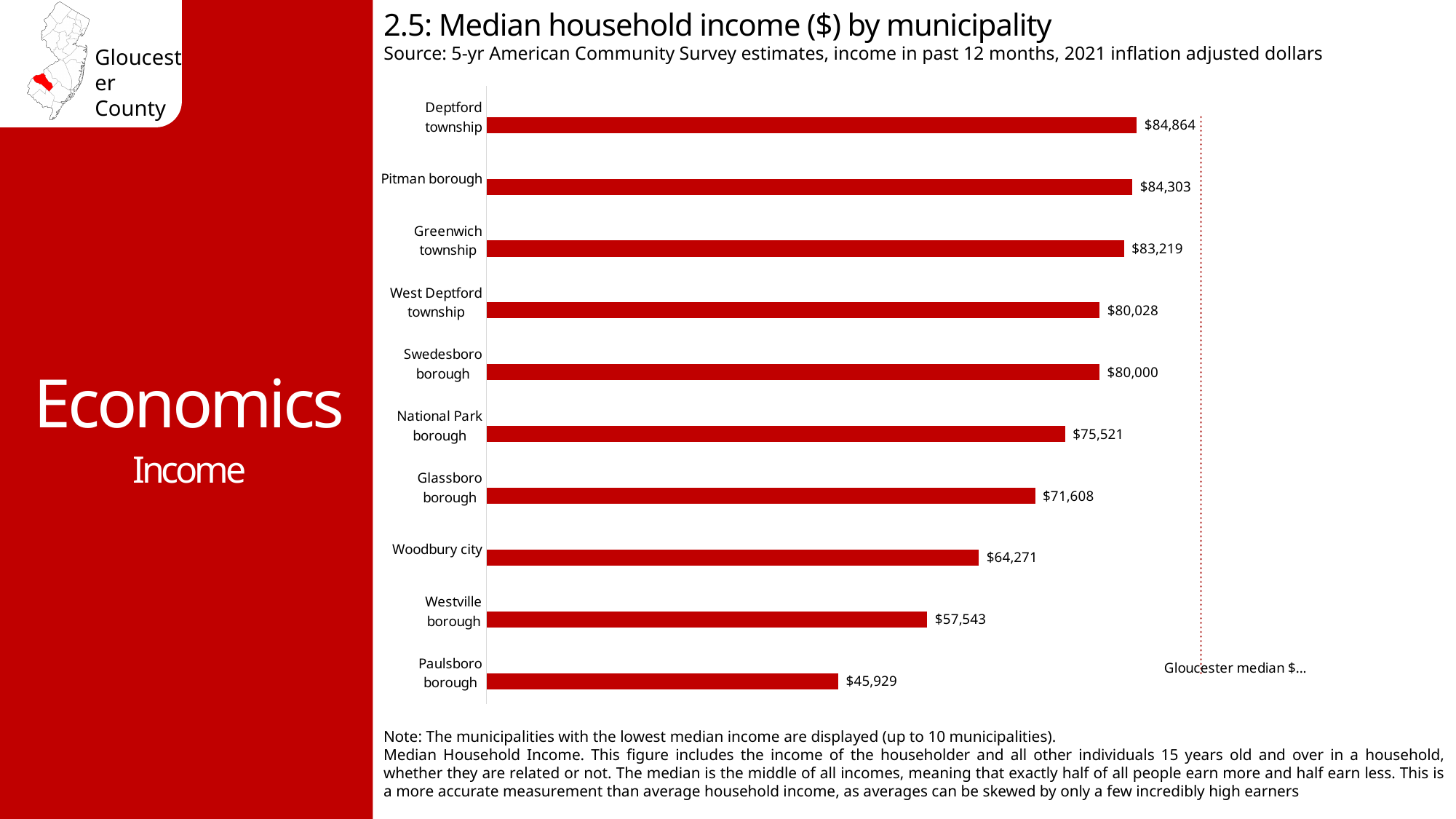
How many municipalities are shown on the chart? 10 What is the median household income for Deptford township? $84,864 What kind of chart is used to show median household income by municipality? Bar chart Which has a higher median household income, National Park borough or Glassboro borough? National Park borough Which municipality has the highest median household income on the chart? Deptford township What is the median household income for Pitman borough? $84,303 What colour are the bars in the chart? Red Which municipality has the lowest median household income on the chart? Paulsboro borough What is the median household income for Glassboro borough? $71,608 What is the median household income for Paulsboro borough? $45,929 What is the difference in median household income between West Deptford township and Swedesboro borough? $28 What is the difference in median household income between Woodbury city and Westville borough? $6,728